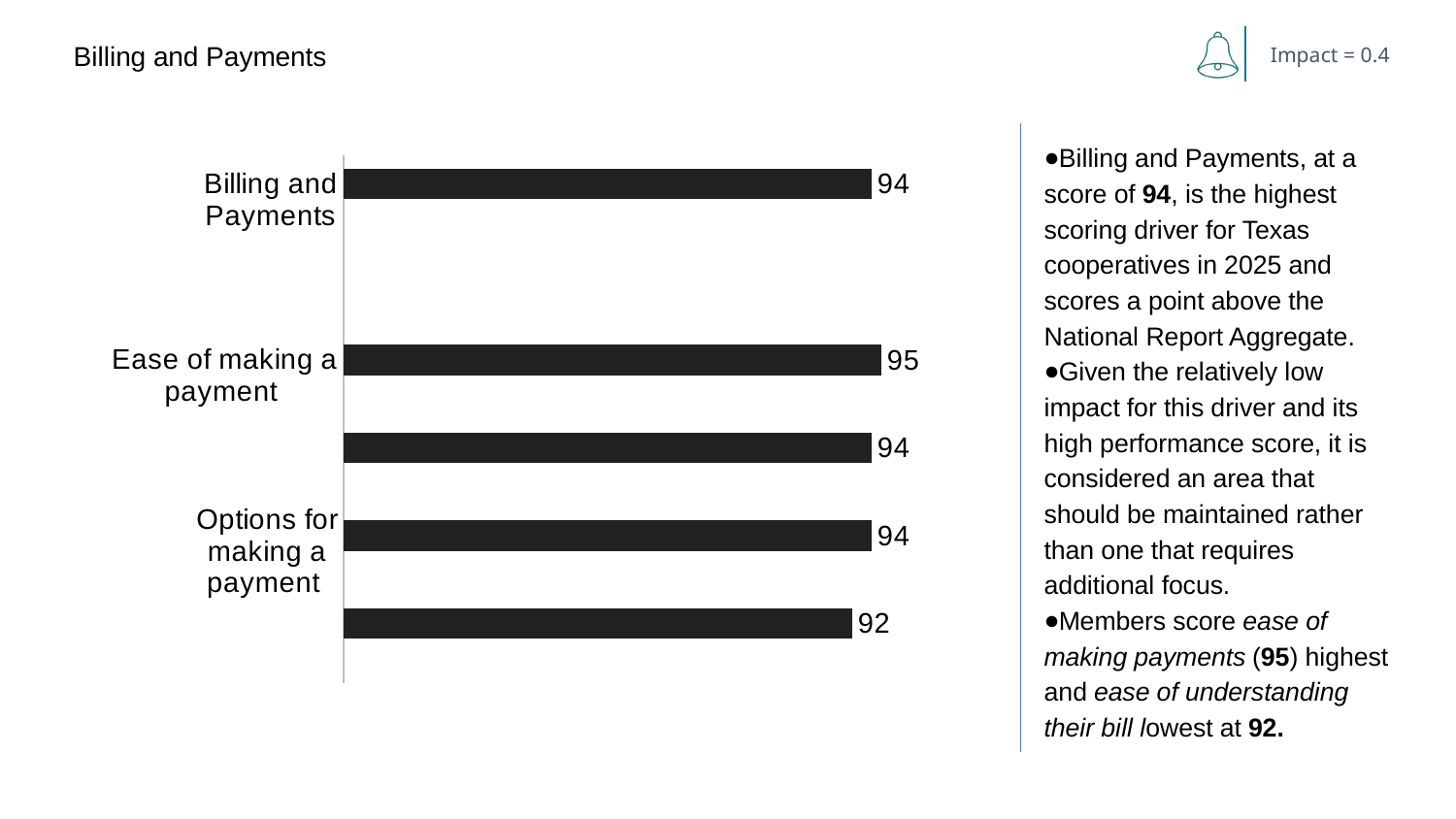
Which is larger, the value for Ease of making a payment or the value for Options for making a payment? Ease of making a payment How many bars are plotted in the chart? 5 What is the highest value shown on any bar in the chart? 95 What is the difference between the highest and lowest bar values in the chart? 3 What is the difference between the value for Ease of making a payment and the value for Billing and Payments? 1 What is the value of the bar for Options for making a payment? 94 What is the value of the bar for Billing and Payments? 94 What is the lowest value shown on any bar in the chart? 92 Which labelled category has the highest value in the chart? Ease of making a payment What is the title of the slide containing the chart? Billing and Payments What kind of chart is shown on the slide? Bar chart What is the value of the bar for Ease of making a payment? 95